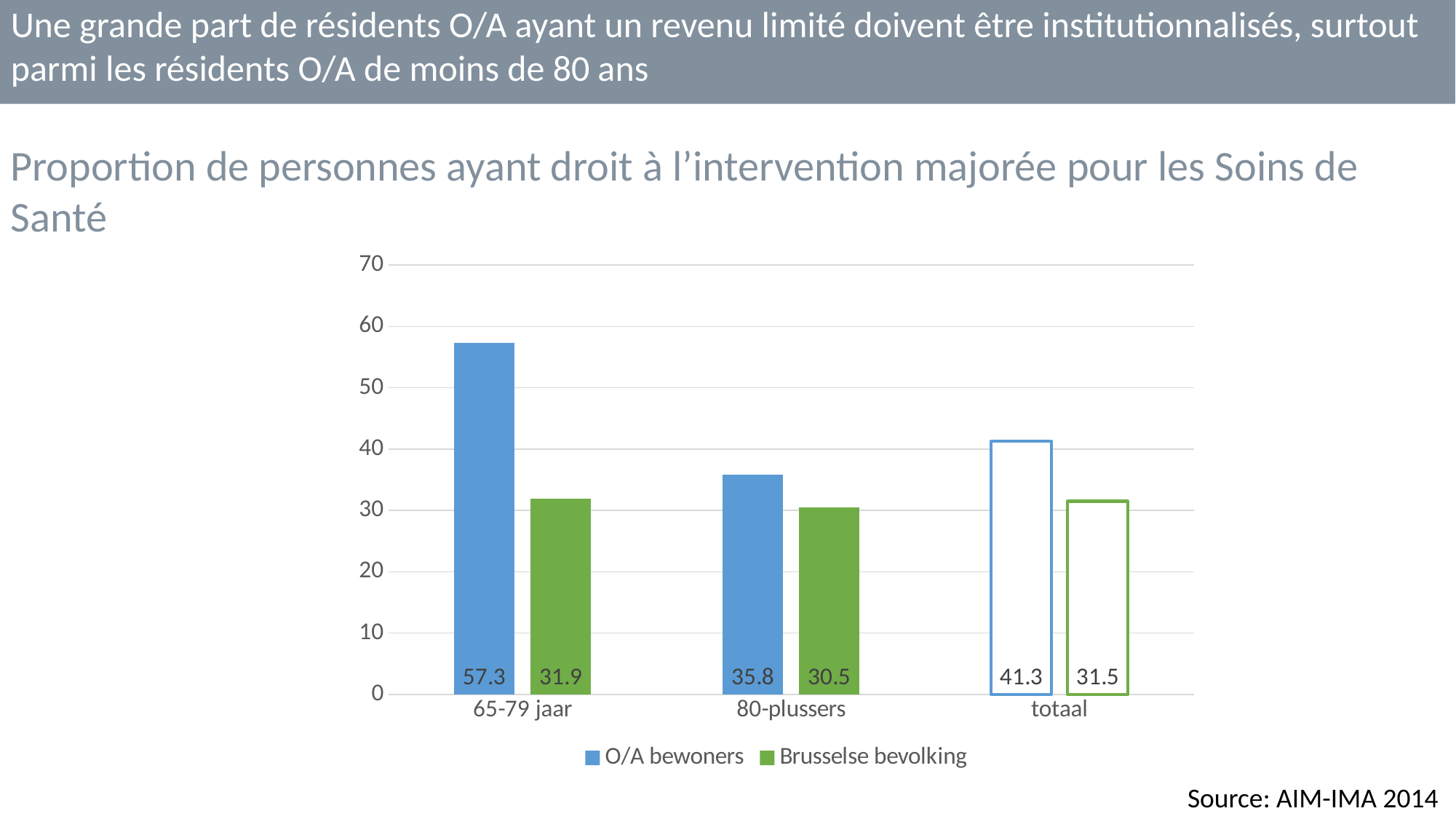
Which category has the highest value for O/A bewoners? 65-79 jaar What is the difference between O/A bewoners and Brusselse bevolking in the 65-79 jaar category? 25.4 What kind of chart is shown on the slide? bar chart What is the value for Brusselse bevolking in the 80-plussers category? 30.5 Is the value for O/A bewoners in the 80-plussers category greater or less than 40? less How many categories are shown on the x axis? 3 What is the value for O/A bewoners in the 65-79 jaar category? 57.3 Which is larger in the totaal category: O/A bewoners or Brusselse bevolking? O/A bewoners How many series does the legend list? 2 Which category has the lowest value for Brusselse bevolking? 80-plussers What is the value for O/A bewoners in the totaal category? 41.3 Which colour represents the Brusselse bevolking series? green